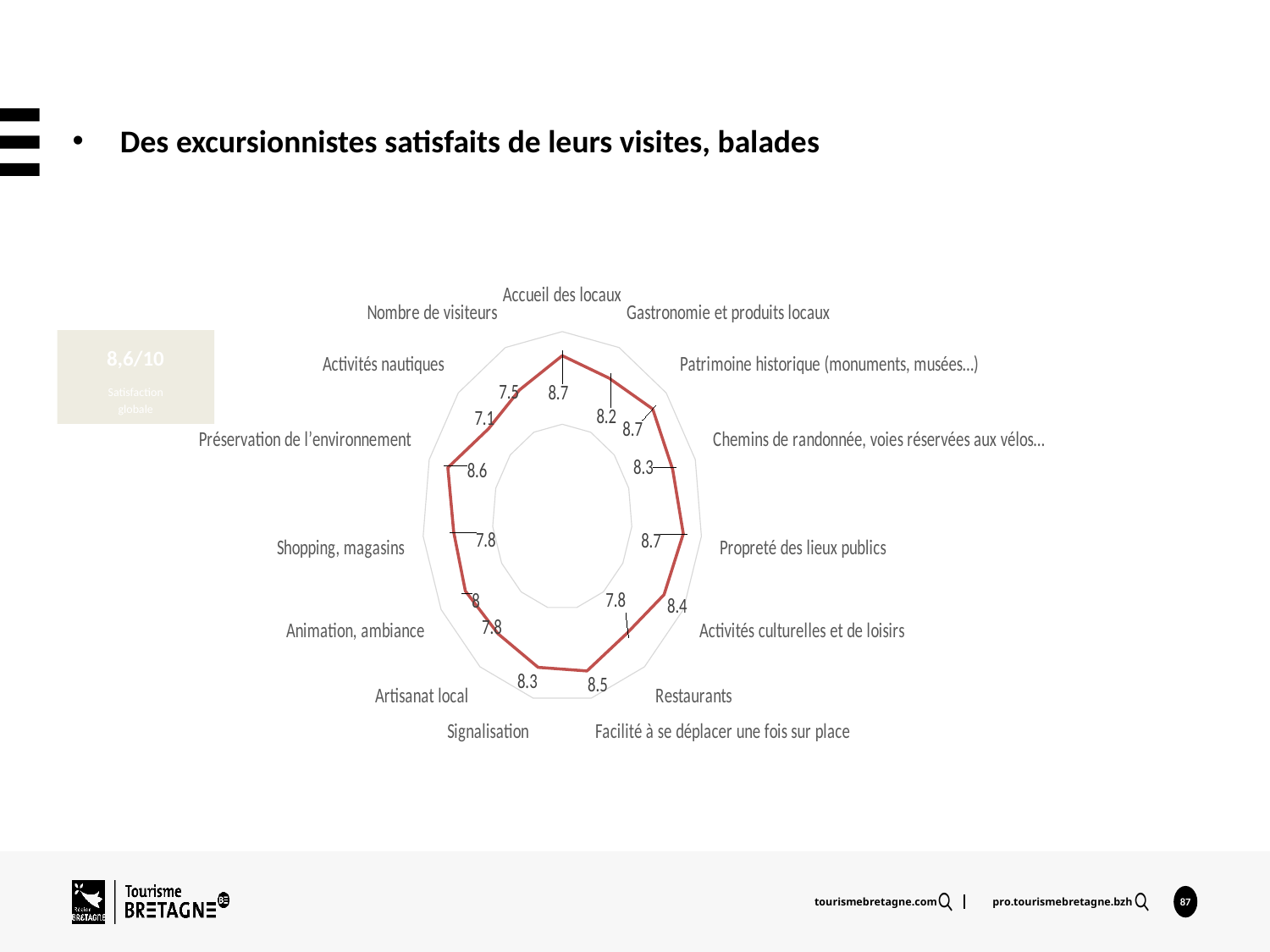
What is the value for Accueil des locaux? 8.7 What kind of chart is shown on the slide? Radar chart What is the value for Propreté des lieux publics? 8.7 What overall satisfaction score (Satisfaction globale) is shown in the box next to the chart? 8,6/10 What is the value for Préservation de l'environnement? 8.6 Which category has the lowest value? Activités nautiques What is the value for Nombre de visiteurs? 7.5 What is the difference between the values for Préservation de l'environnement and Activités nautiques? 1.5 What is the value for Activités nautiques? 7.1 How many categories are plotted on the radar chart? 15 What is the value for Facilité à se déplacer une fois sur place? 8.5 Which is larger, the value for Propreté des lieux publics or the value for Shopping, magasins? Propreté des lieux publics